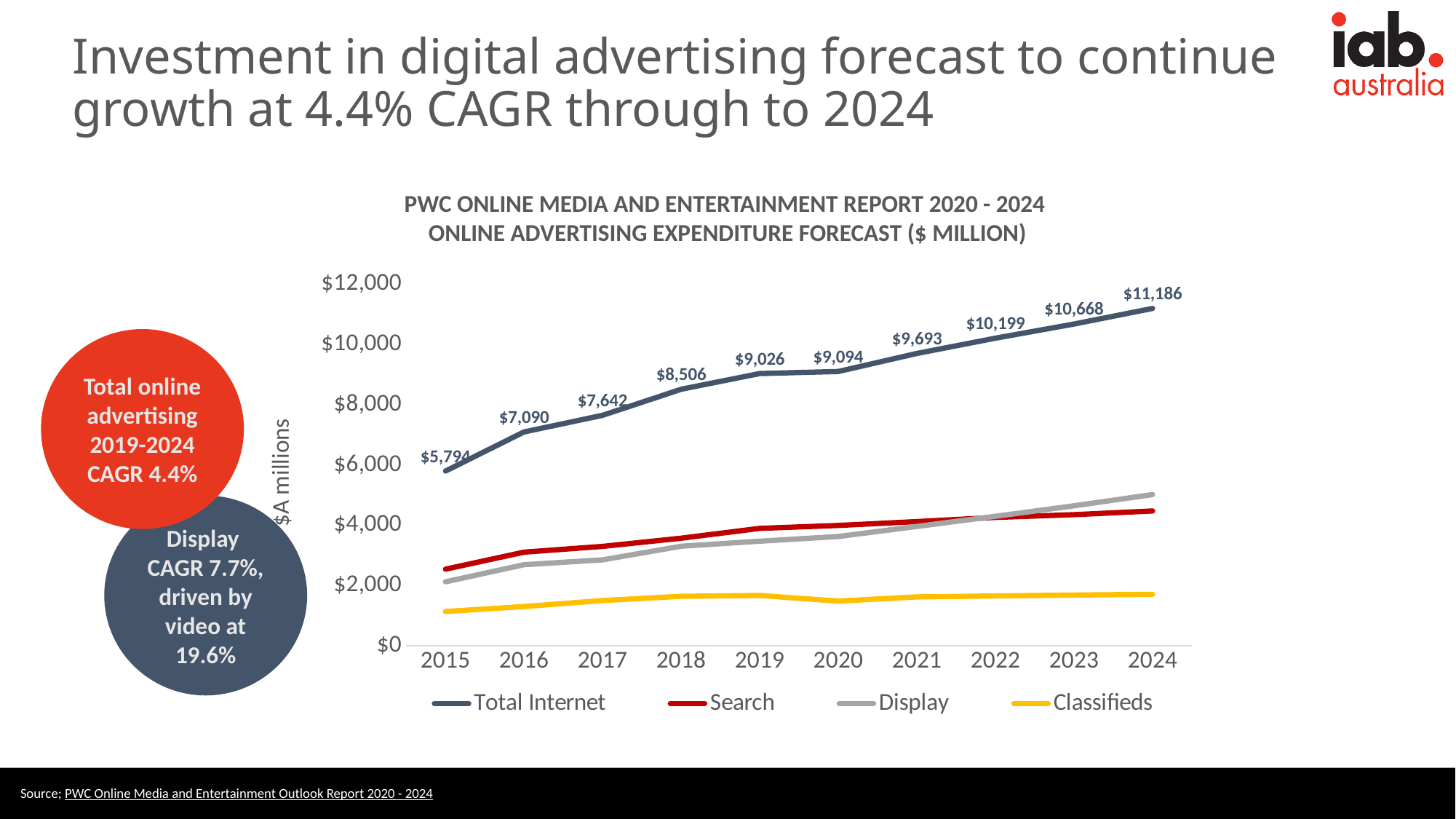
What is the Total Internet value for 2015? $5,794 How many series does the legend list? 4 What is the Total Internet value for 2024? $11,186 How many years are shown on the x axis? 10 What is the Total Internet value for 2020? $9,094 Does the Total Internet series rise or fall from 2015 to 2024? rise In which year is the Total Internet value highest? 2024 Which series is shown in yellow in the legend? Classifieds What type of chart is shown on the slide? line chart In which year is the Total Internet value lowest? 2015 What is the difference between the Total Internet values for 2024 and 2023? $518 Is the Classifieds value for 2024 greater or less than $2,000? less